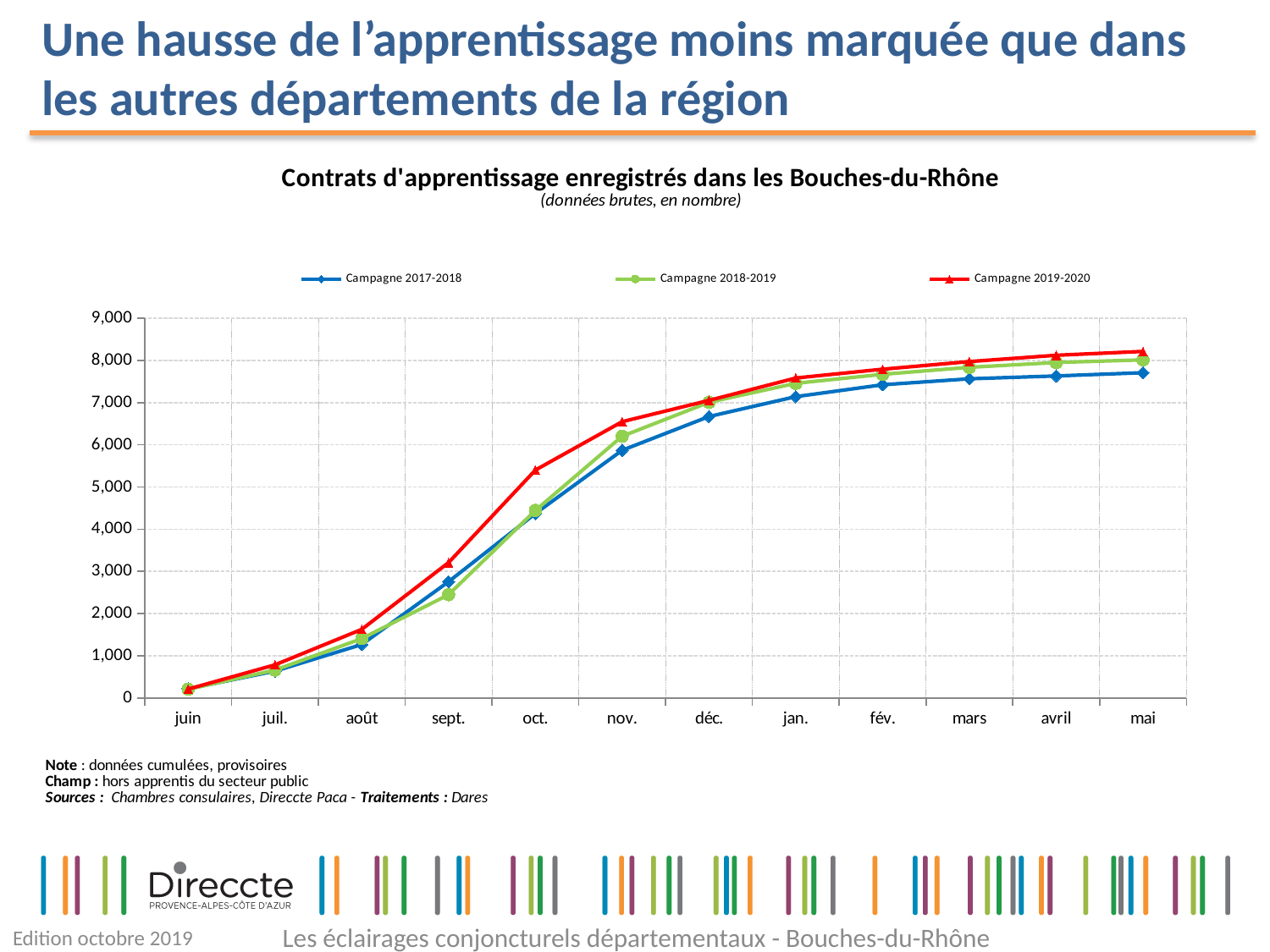
Is the value for Campagne 2017-2018 in mai greater or less than 8,000? less In sept., which series has the higher value: Campagne 2019-2020 or Campagne 2017-2018? Campagne 2019-2020 What kind of chart is shown on the slide? line chart Is the value for Campagne 2019-2020 in oct. greater or less than 5,000? greater Is the value for Campagne 2019-2020 in mai greater or less than 8,000? greater How many series does the legend list? 3 What colour is the line for Campagne 2019-2020? red Do the values for Campagne 2019-2020 rise or fall from juin to mai? rise How many months are shown along the x axis? 12 Which series has the highest value in mai? Campagne 2019-2020